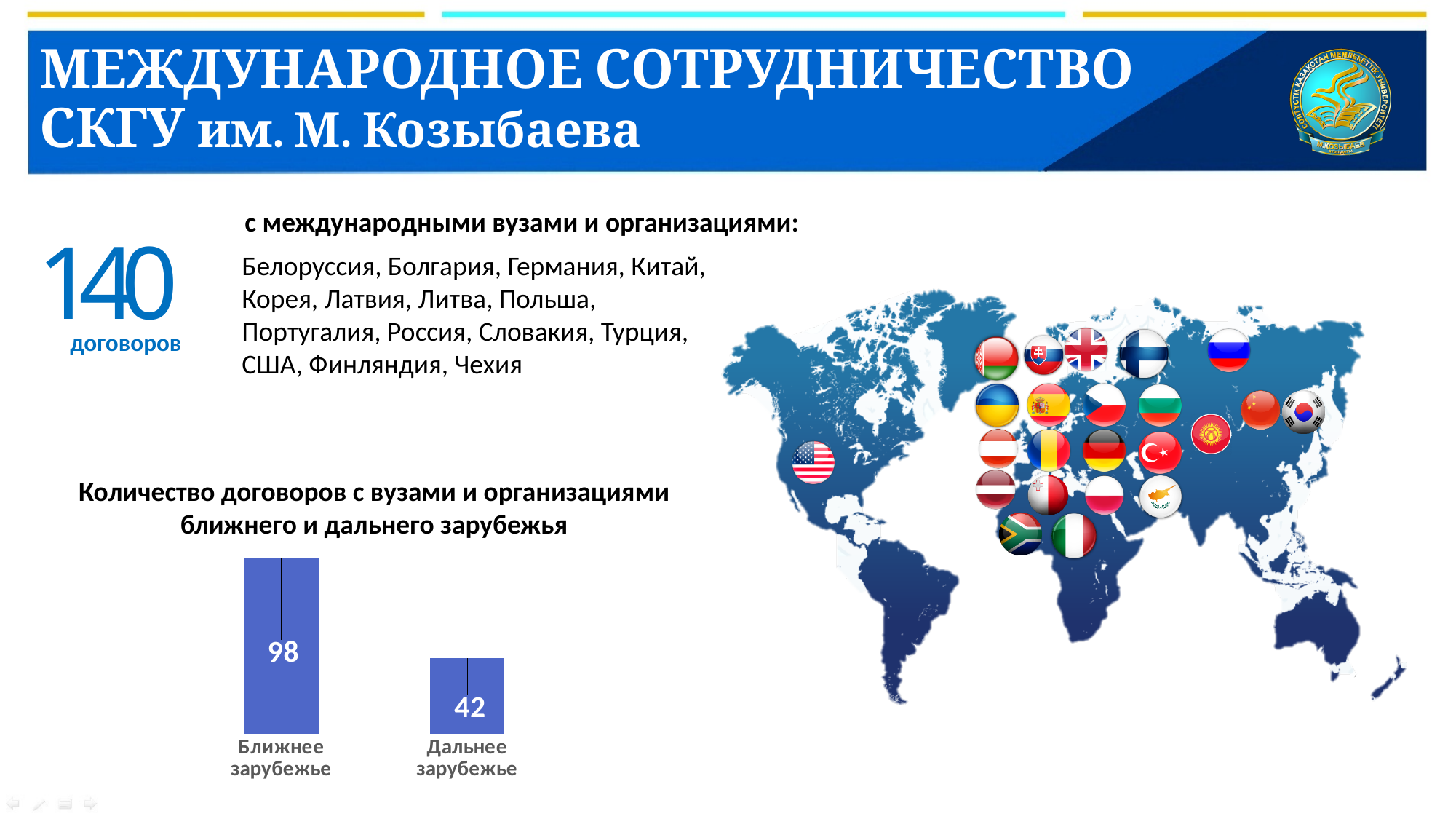
Which category has the lowest value in the chart? Дальнее зарубежье What is the title of the chart? Количество договоров с вузами и организациями ближнего и дальнего зарубежья What is the value for Дальнее зарубежье in the chart? 42 What colour are the bars in the chart? blue What is the value for Ближнее зарубежье in the chart? 98 Which is larger: the value for Ближнее зарубежье or Дальнее зарубежье? Ближнее зарубежье What kind of chart is shown on the slide? bar chart What is the total of the two values shown in the chart? 140 Which category has the highest value in the chart? Ближнее зарубежье How many categories are shown in the chart? 2 What is the difference between the values for Ближнее зарубежье and Дальнее зарубежье? 56